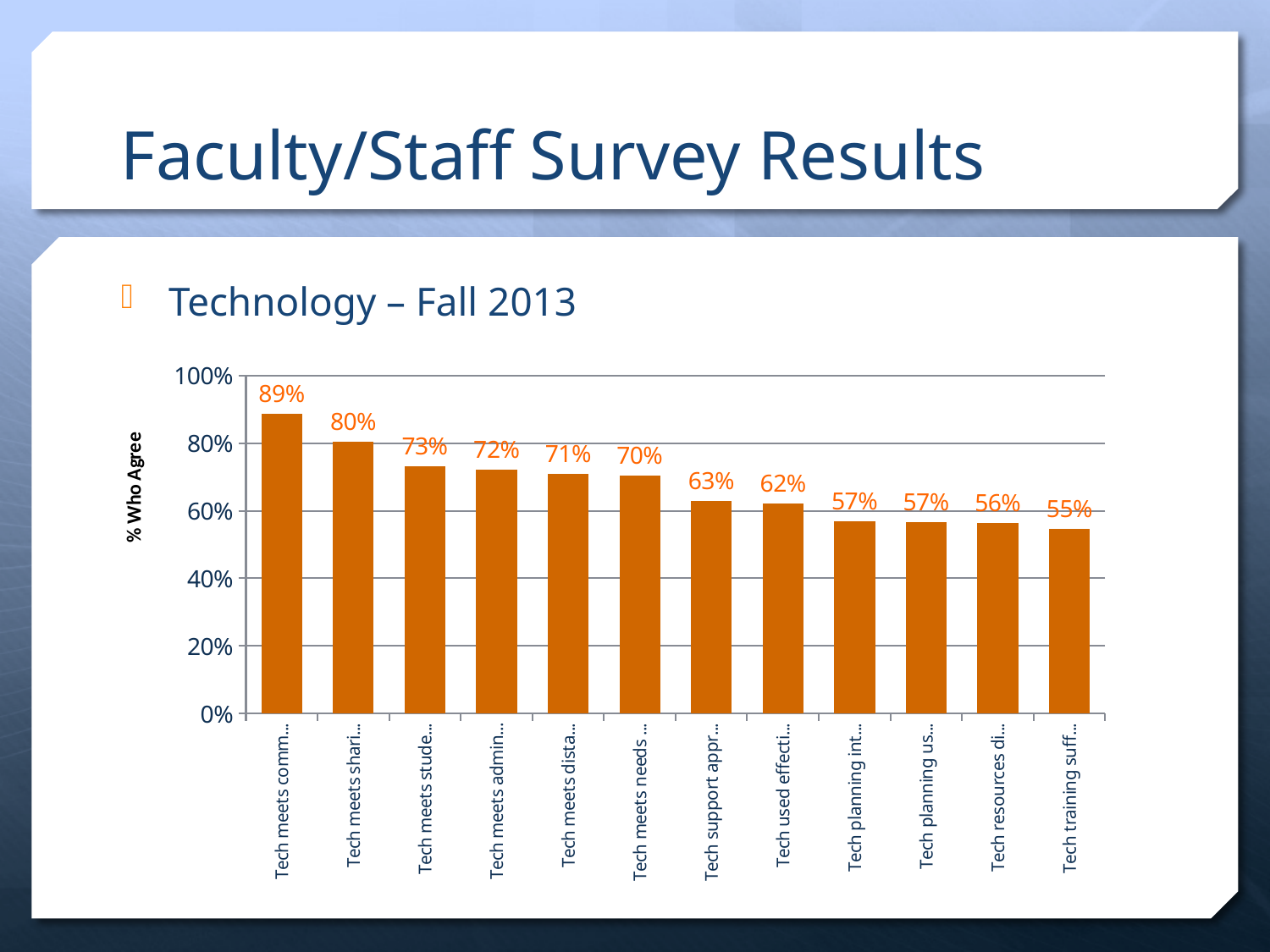
How many bars are plotted in the chart? 12 Do the bar values rise or fall from left to right along the x axis? fall Which bar has the lowest value? Tech training suff… (the last bar) What is the value of the last (rightmost) bar, labelled "Tech training suff…"? 55% What is the label on the vertical axis? % Who Agree Which is larger, the value for "Tech meets shari…" or the value for "Tech meets stude…"? Tech meets shari… What is the difference between the highest value (89%) and the lowest value (55%)? 34% What kind of chart is shown on the slide? bar chart What is the value of the bar labelled "Tech used effecti…"? 62% Which bar has the highest value? Tech meets comm… (the first bar) What is the value of the bar labelled "Tech support appr…"? 63% What is the value of the first (leftmost) bar, labelled "Tech meets comm…"? 89%